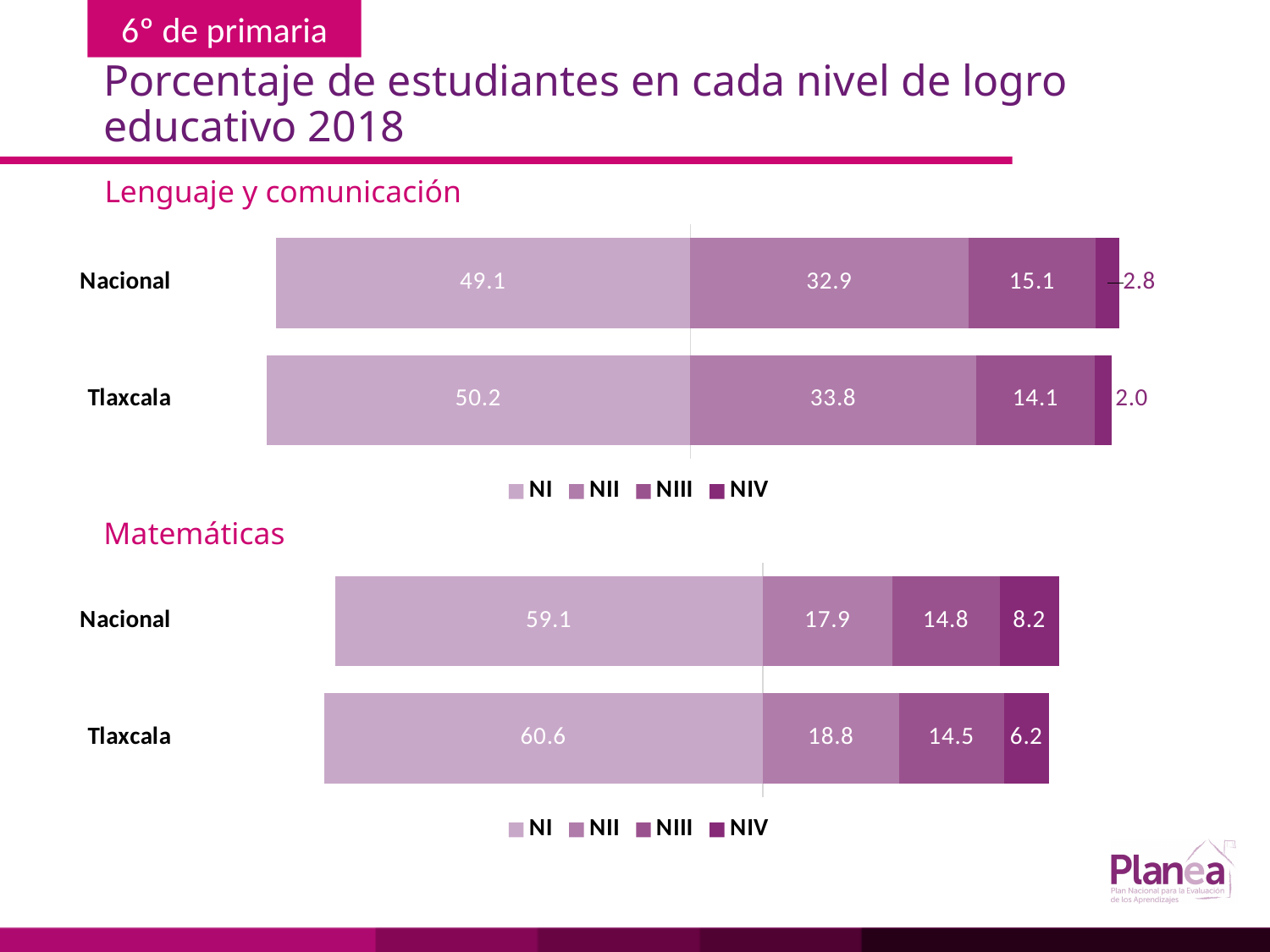
In the Matemáticas chart, what is the NIV value for Nacional? 8.2 How many categories are shown in the Lenguaje y comunicación chart? 2 In the Lenguaje y comunicación chart, which is larger, the NIII value for Nacional or for Tlaxcala? Nacional In the Matemáticas chart, what is the difference between the NI values for Tlaxcala and Nacional? 1.5 In the Matemáticas chart, what is the total of the Nacional stacked bar? 100.0 How many series does the legend of the Matemáticas chart list? 4 In the Matemáticas chart, which level has the highest value for Nacional? NI In the Matemáticas chart, what is the NII value for Tlaxcala? 18.8 In the Lenguaje y comunicación chart, what is the NIV value for Nacional? 2.8 In the Lenguaje y comunicación chart, what is the NI value for Tlaxcala? 50.2 What type of chart is the Lenguaje y comunicación chart? Stacked bar chart In the Lenguaje y comunicación chart, which level has the lowest value for Tlaxcala? NIV